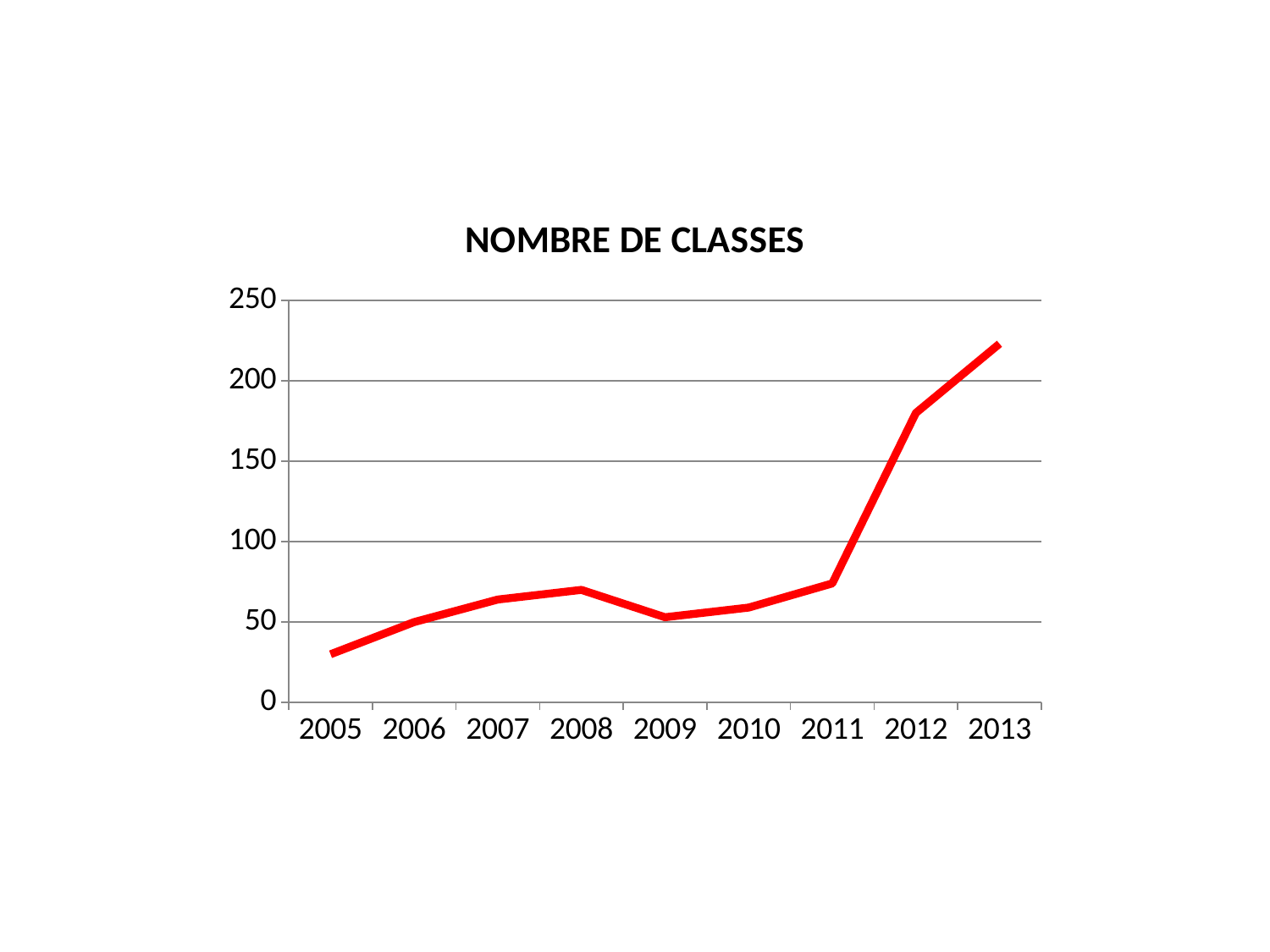
Is the value for 2012 greater or less than 150? greater Which year has the lowest number of classes? 2005 Does the number of classes overall rise or fall from 2005 to 2013? rise Is the value for 2011 greater or less than 100? less How many years are plotted on the x axis? 9 What type of chart is shown on the slide? line chart Which year has the highest number of classes? 2013 What is the title of the chart? NOMBRE DE CLASSES Is the value for 2005 greater or less than 50? less Which year has a larger value, 2011 or 2012? 2012 Which year has a larger value, 2008 or 2009? 2008